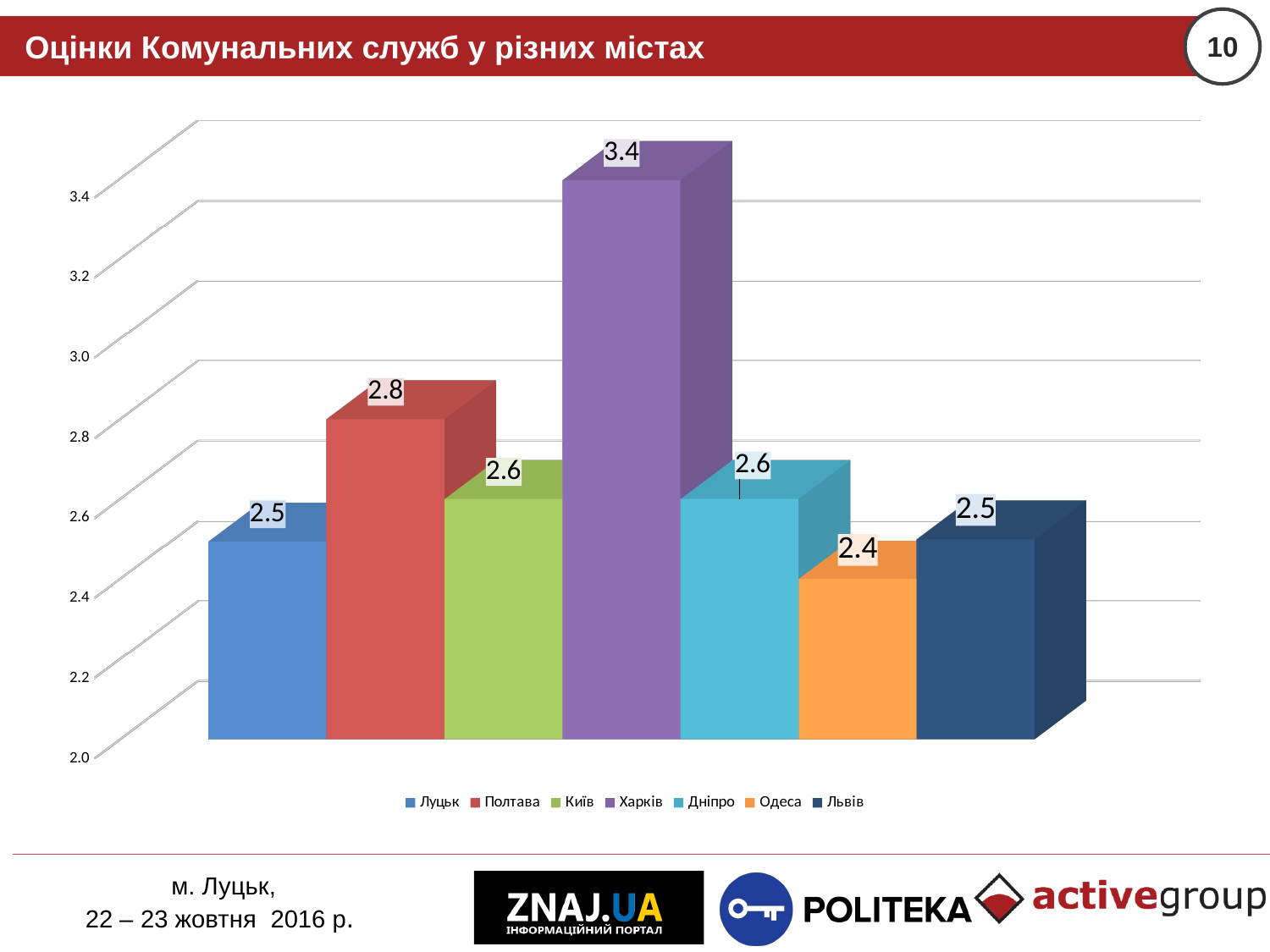
Which city has the highest value? Харків What is the value for Одеса? 2.4 Is the value for Харків greater or less than 3.0? greater What is the title of the slide? Оцінки Комунальних служб у різних містах What is the value for Харків? 3.4 What is the difference between the values for Харків and Полтава? 0.6 Which is larger, the value for Полтава or the value for Київ? Полтава What kind of chart is shown on the slide? bar chart How many cities are shown in the chart? 7 Which city has the lowest value? Одеса What is the value for Львів? 2.5 What is the value for Полтава? 2.8